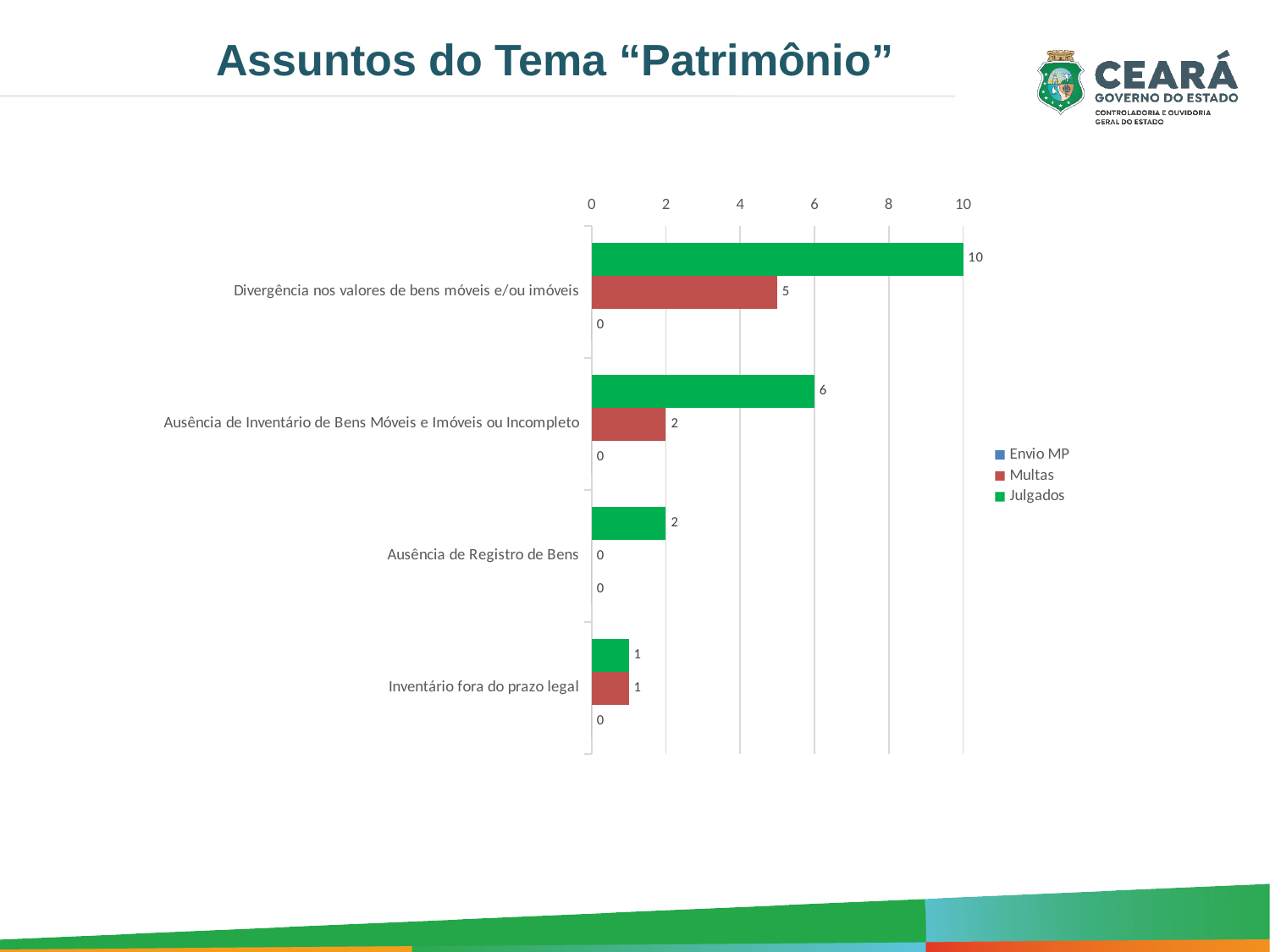
Which category has the highest Julgados value? Divergência nos valores de bens móveis e/ou imóveis What is the Julgados value for "Divergência nos valores de bens móveis e/ou imóveis"? 10 How many categories are shown on the chart? 4 What is the Multas value for "Divergência nos valores de bens móveis e/ou imóveis"? 5 What kind of chart is shown on the slide? Bar chart What is the difference between the Julgados and Multas values for "Divergência nos valores de bens móveis e/ou imóveis"? 5 What is the Multas value for "Inventário fora do prazo legal"? 1 How many series does the legend list? 3 Which is larger for "Ausência de Inventário de Bens Móveis e Imóveis ou Incompleto": Julgados or Multas? Julgados What is the Envio MP value for "Ausência de Registro de Bens"? 0 Which category has the lowest Julgados value? Inventário fora do prazo legal What is the Julgados value for "Ausência de Inventário de Bens Móveis e Imóveis ou Incompleto"? 6